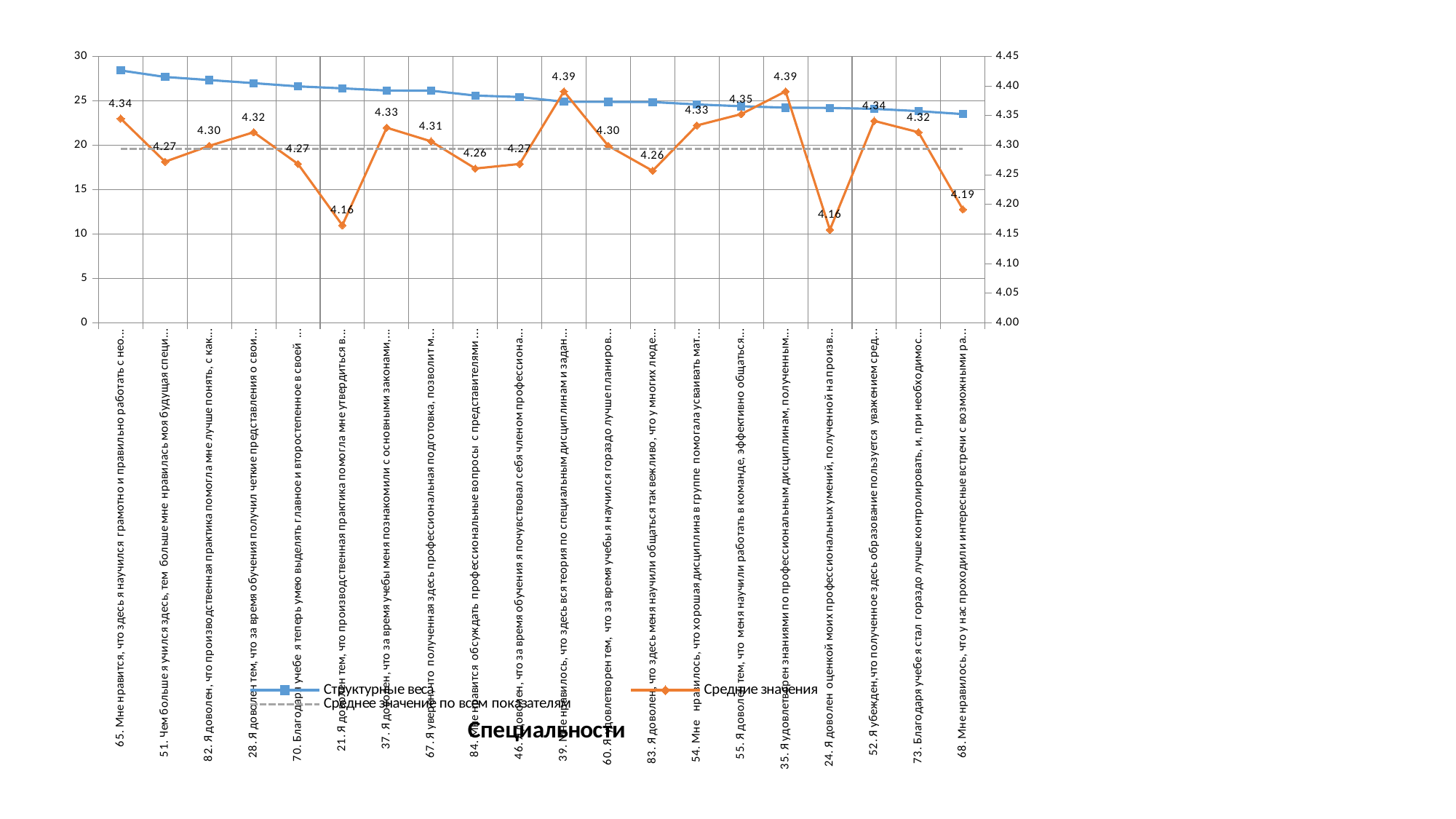
What is the difference between the highest (4.39) and lowest (4.16) values of the 'Средние значения' series? 0.23 How many series does the legend list? 3 Which has the larger 'Средние значения' value: item 65 or item 51? item 65 Is the 'Структурные веса' value for the first category (item 65) greater or less than 25? greater What is the highest value shown for the 'Средние значения' series? 4.39 What is the lowest value shown for the 'Средние значения' series? 4.16 What kind of chart is shown on the slide? line chart What is the value of the 'Средние значения' series for the last category (item 68)? 4.19 What is the value of the 'Средние значения' series for item 55? 4.35 What is the value of the 'Средние значения' series for the first category (item 65)? 4.34 Does the 'Структурные веса' series rise or fall from left to right along the x axis? fall How many categories are plotted along the x axis? 20